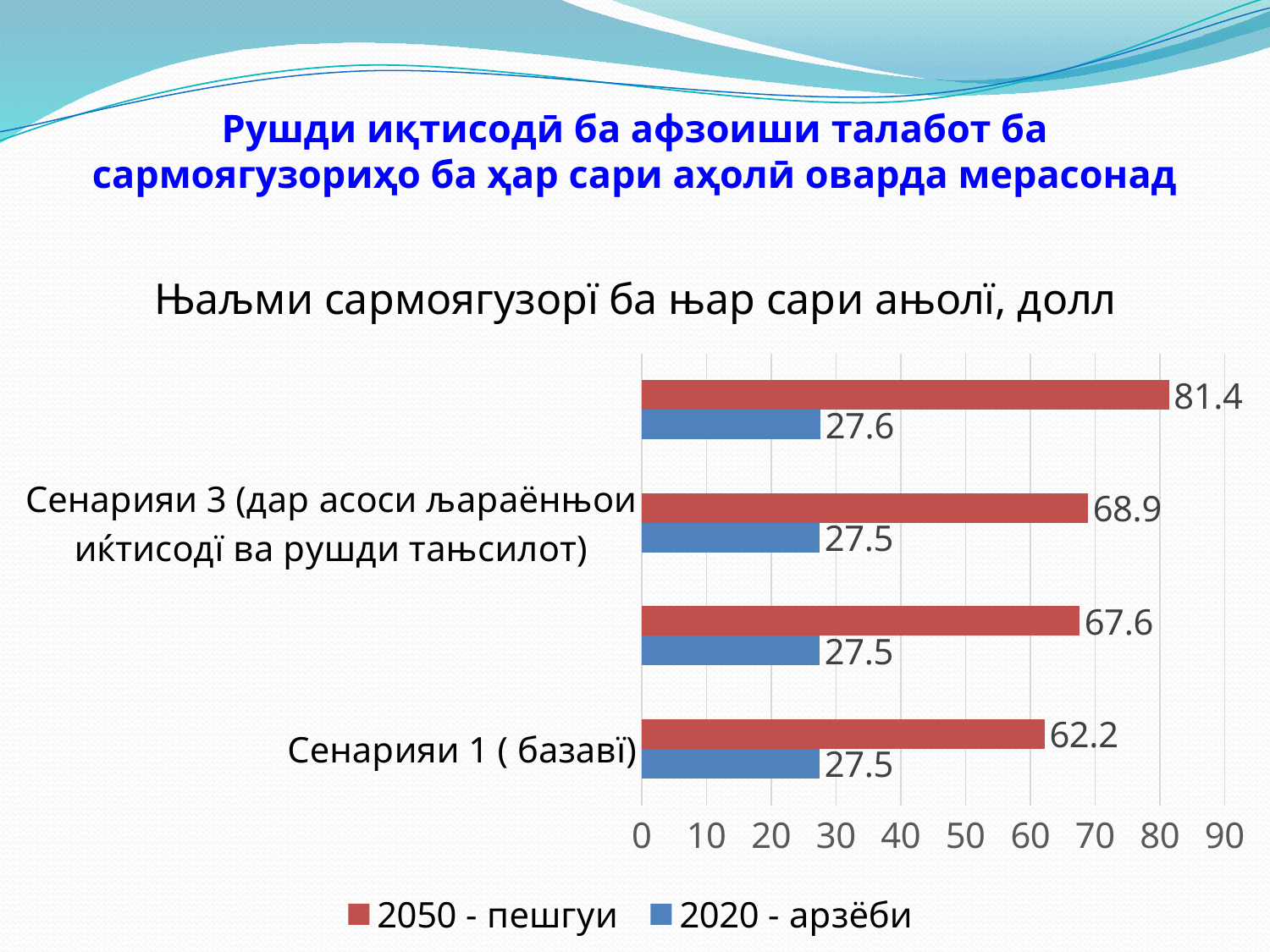
What is the highest 2050 - пешгуи value shown in the chart? 81.4 What is the difference between the 2050 - пешгуи and 2020 - арзёби values for Сенарияи 1 ( базавї)? 34.7 What is the 2020 - арзёби value for Сенарияи 3? 27.5 What is the difference between the 2050 - пешгуи values for Сенарияи 3 and Сенарияи 1 ( базавї)? 6.7 What is the title of the chart? Њаљми сармоягузорї ба њар сари ањолї, долл Which is larger for Сенарияи 3: the 2050 - пешгуи value or the 2020 - арзёби value? 2050 - пешгуи What type of chart is shown on the slide? bar chart How many categories are plotted in the chart? 4 How many series does the legend list? 2 What is the 2050 - пешгуи value for Сенарияи 1 ( базавї)? 62.2 What is the 2050 - пешгуи value for Сенарияи 3? 68.9 What is the 2020 - арзёби value for Сенарияи 1 ( базавї)? 27.5